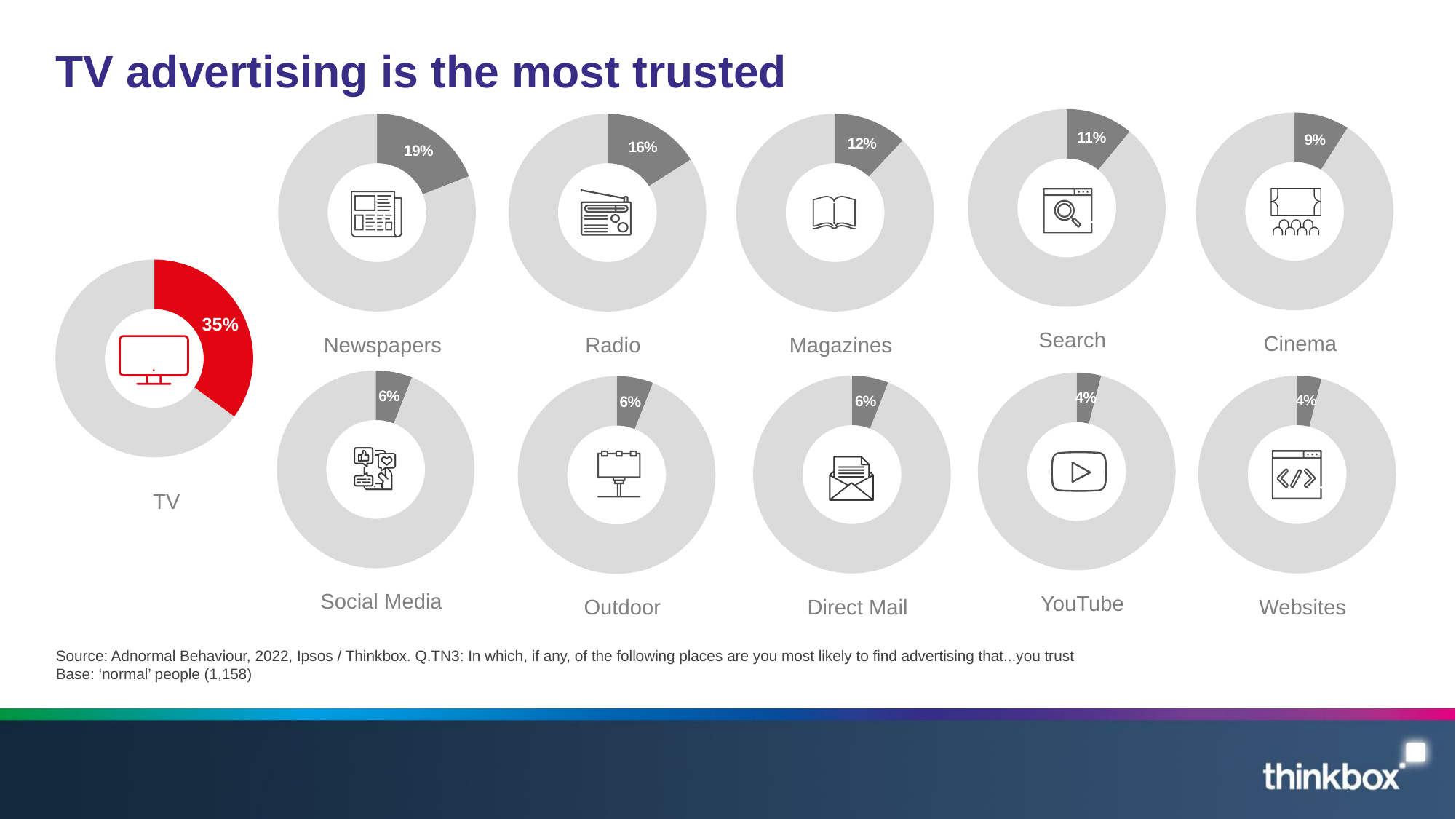
What percentage is shown for Cinema? 9% Which has a larger percentage, Radio or Magazines? Radio What percentage is shown for Newspapers? 19% What percentage is shown for Radio? 16% What is the difference between the Magazines percentage and the Search percentage? 1% What percentage is shown for TV? 35% What is the difference between the TV percentage and the Newspapers percentage? 16% How many media categories are shown on the slide? 11 Which medium has the highest percentage on the slide? TV What percentage is shown for YouTube? 4% What kind of chart is used for each medium on the slide? Donut chart What is the title of the slide? TV advertising is the most trusted